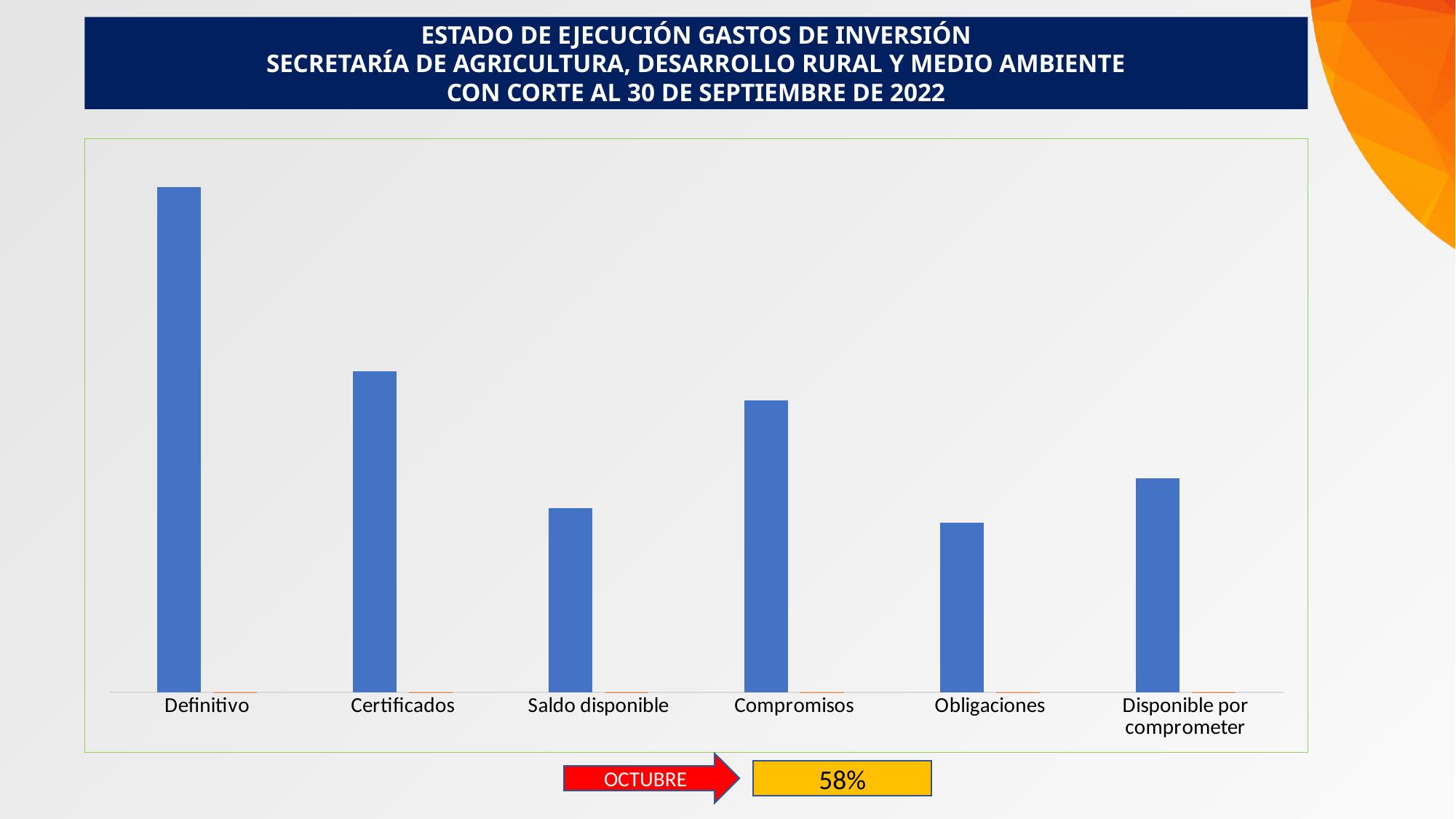
How many categories are shown on the x axis of the chart? 6 Which category has the shortest bar in the chart? Obligaciones Which category has the tallest bar in the chart? Definitivo Which bar is taller, Saldo disponible or Definitivo? Definitivo Which bar is taller, Certificados or Compromisos? Certificados What kind of chart is shown on the slide? Bar chart What is the label of the last category on the x axis of the chart? Disponible por comprometer What cut-off date is stated in the slide heading above the chart? 30 de septiembre de 2022 Which bar is taller, Compromisos or Obligaciones? Compromisos